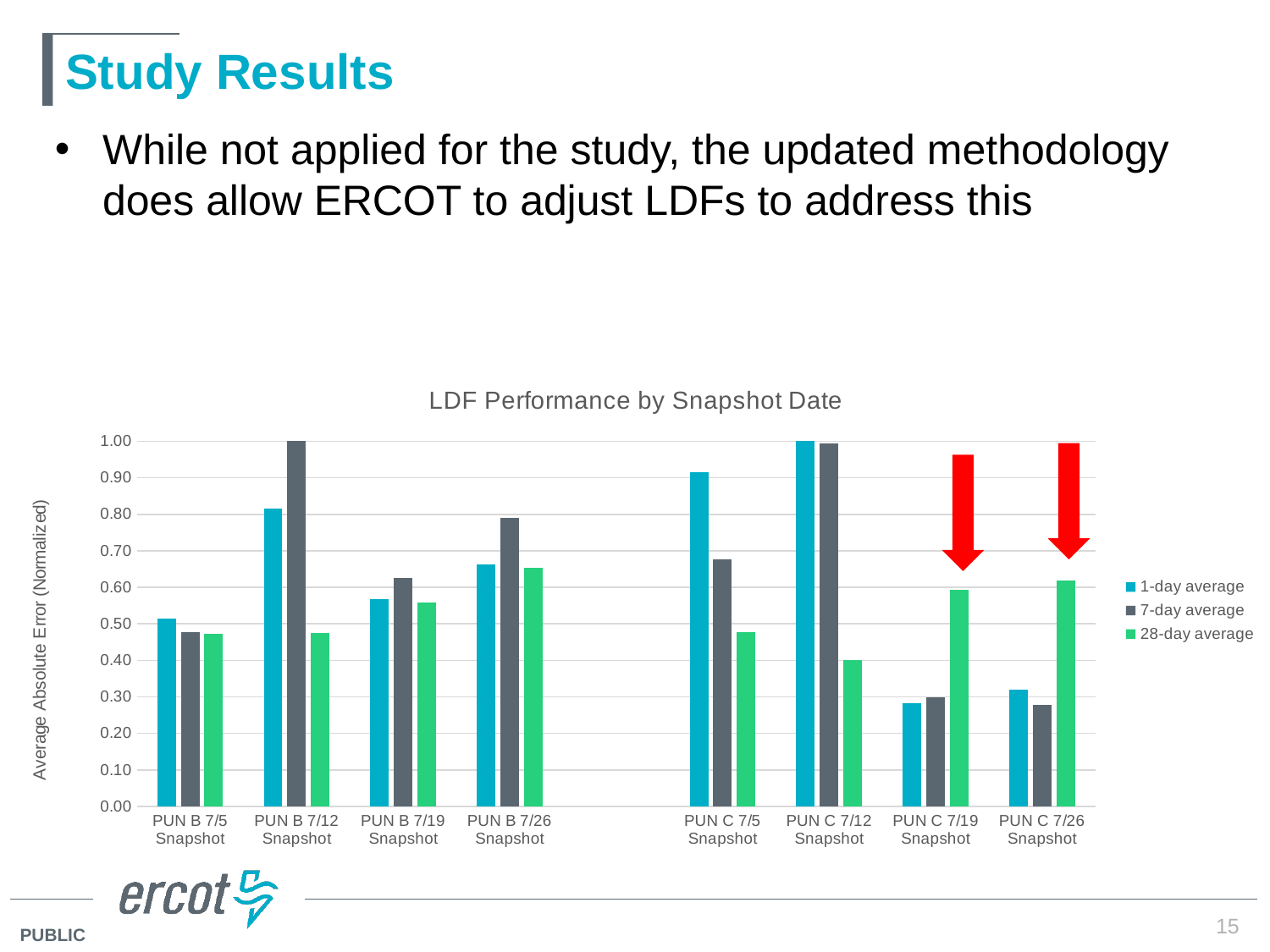
Which snapshot has the lowest 28-day average value? PUN C 7/12 Snapshot Is the 1-day average value for PUN C 7/19 Snapshot greater or less than 0.30? less What kind of chart is shown on the slide? Bar chart What is the 1-day average value for PUN C 7/12 Snapshot? 1.00 What is the y-axis label of the chart? Average Absolute Error (Normalized) For PUN C 7/19 Snapshot, which is larger: the 1-day average or the 28-day average? 28-day average What is the title of the chart? LDF Performance by Snapshot Date Which snapshot has the highest 1-day average value? PUN C 7/12 Snapshot What is the 7-day average value for PUN B 7/12 Snapshot? 1.00 Is the 7-day average value for PUN B 7/26 Snapshot greater or less than 0.70? greater How many series does the legend list? 3 How many snapshot categories are shown on the x axis? 8